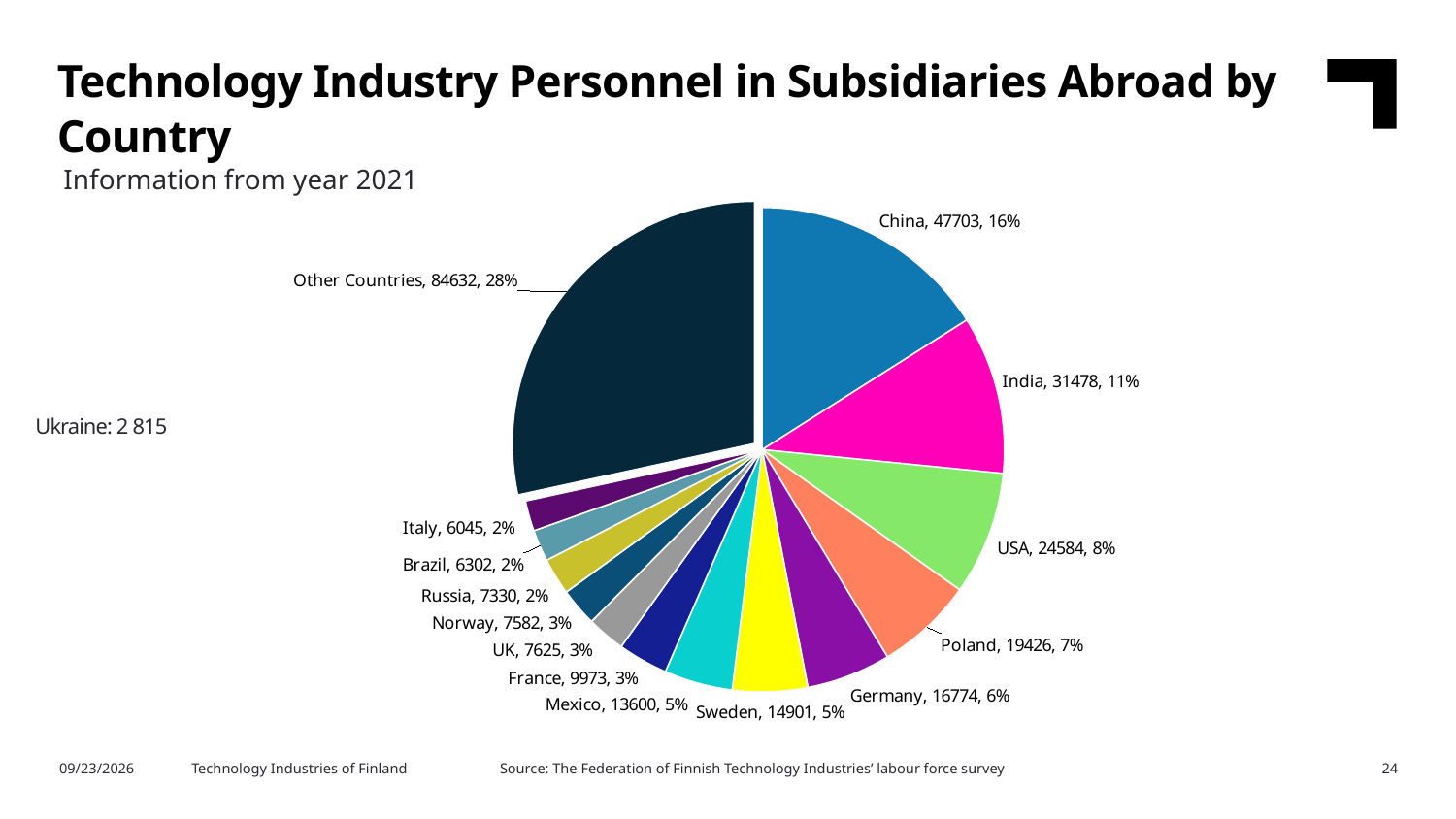
What is the title of the chart on the slide? Technology Industry Personnel in Subsidiaries Abroad by Country What is the difference between the values for China and India? 16225 How many slices does the pie chart have? 14 Which named country has the smallest slice? Italy What is the value shown for Poland? 19426 How many personnel are in subsidiaries in China? 47703 What kind of chart is shown on the slide? Pie chart What percentage share is shown for Other Countries? 28% Which slice of the pie is the largest? Other Countries What is the value shown for Mexico? 13600 What share of the pie does India represent? 11% Which is larger, the value for Germany or the value for Sweden? Germany